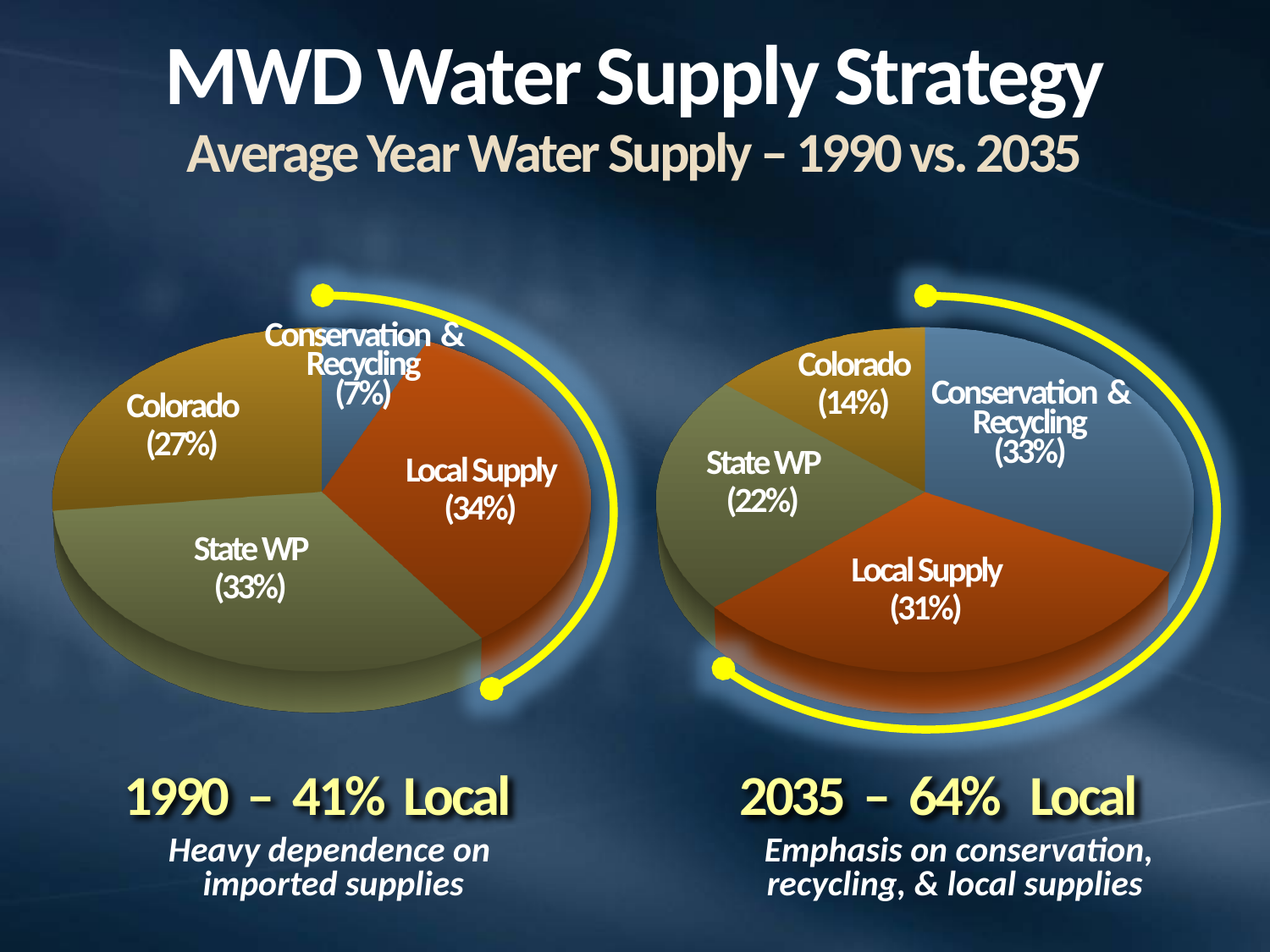
What is the difference between the Colorado share in the 1990 chart and the Colorado share in the 2035 chart? 13% In the 1990 pie chart (left), what share does Local Supply have? 34% In the 1990 pie chart (left), which category has the smallest share? Conservation & Recycling What kind of charts are shown on the slide? Pie charts In the 1990 pie chart (left), which category has the largest share? Local Supply In the 1990 pie chart (left), what share does Colorado have? 27% What is the subtitle of the slide above the two pie charts? Average Year Water Supply – 1990 vs. 2035 Which is larger: the State WP share in the 1990 chart or the State WP share in the 2035 chart? 1990 In the 2035 pie chart (right), what share does Conservation & Recycling have? 33% In the 2035 pie chart (right), which category has the smallest share? Colorado How many slices does the 2035 pie chart (right) have? 4 In the 2035 pie chart (right), what share does State WP have? 22%